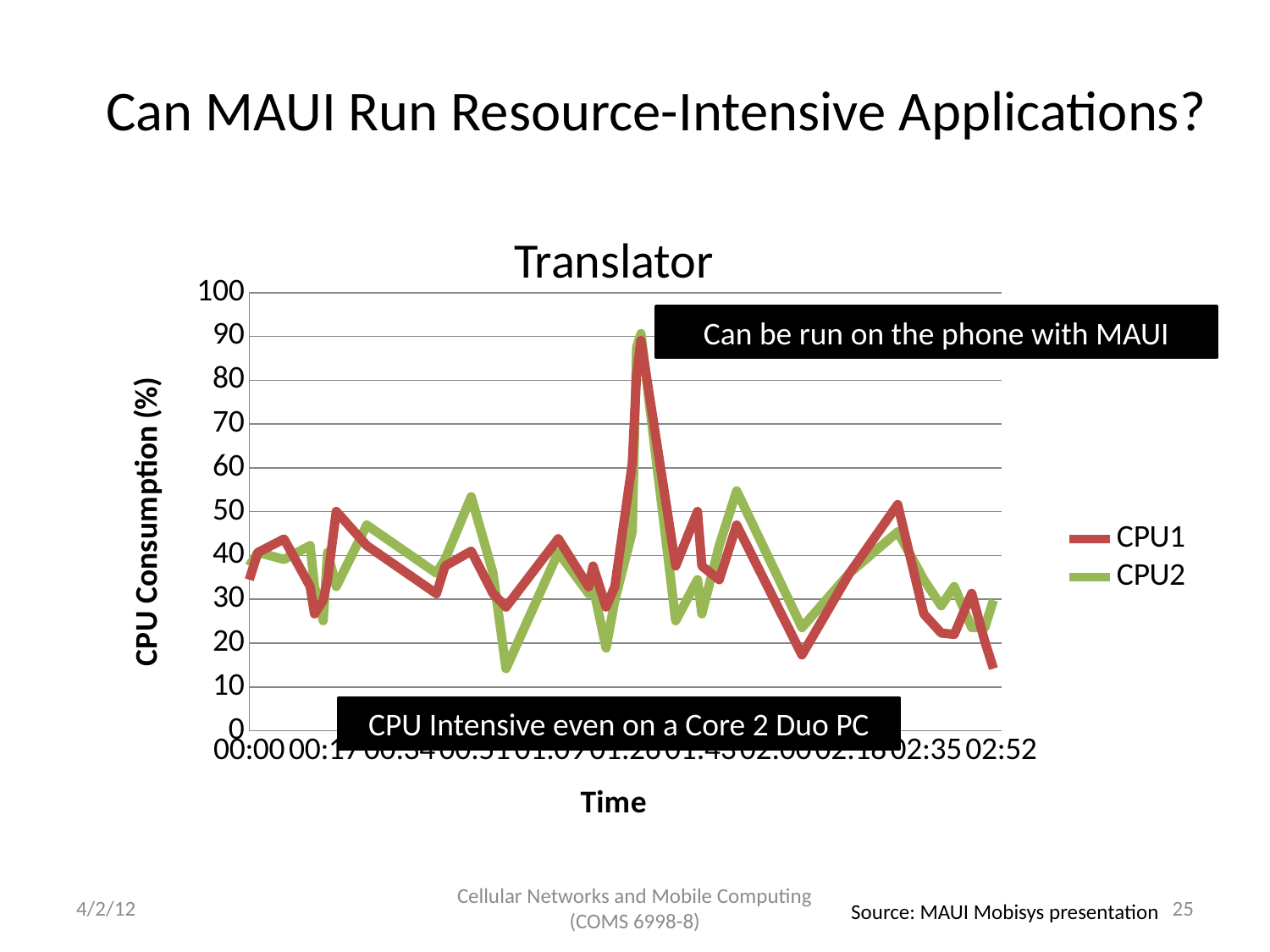
What is the label of the x axis? Time How many time labels are shown along the x axis? 11 Is the highest value reached by CPU2 greater or less than 80? greater Is the highest value reached by CPU1 greater or less than 80? greater What is the title of the chart? Translator What is the label of the y axis? CPU Consumption (%) What kind of chart is shown on the slide? line chart Is the lowest value reached by CPU2 greater or less than 20? less At 02:52, which series has the larger value, CPU1 or CPU2? CPU2 How many series does the legend list? 2 What are the names of the two series in the legend? CPU1 and CPU2